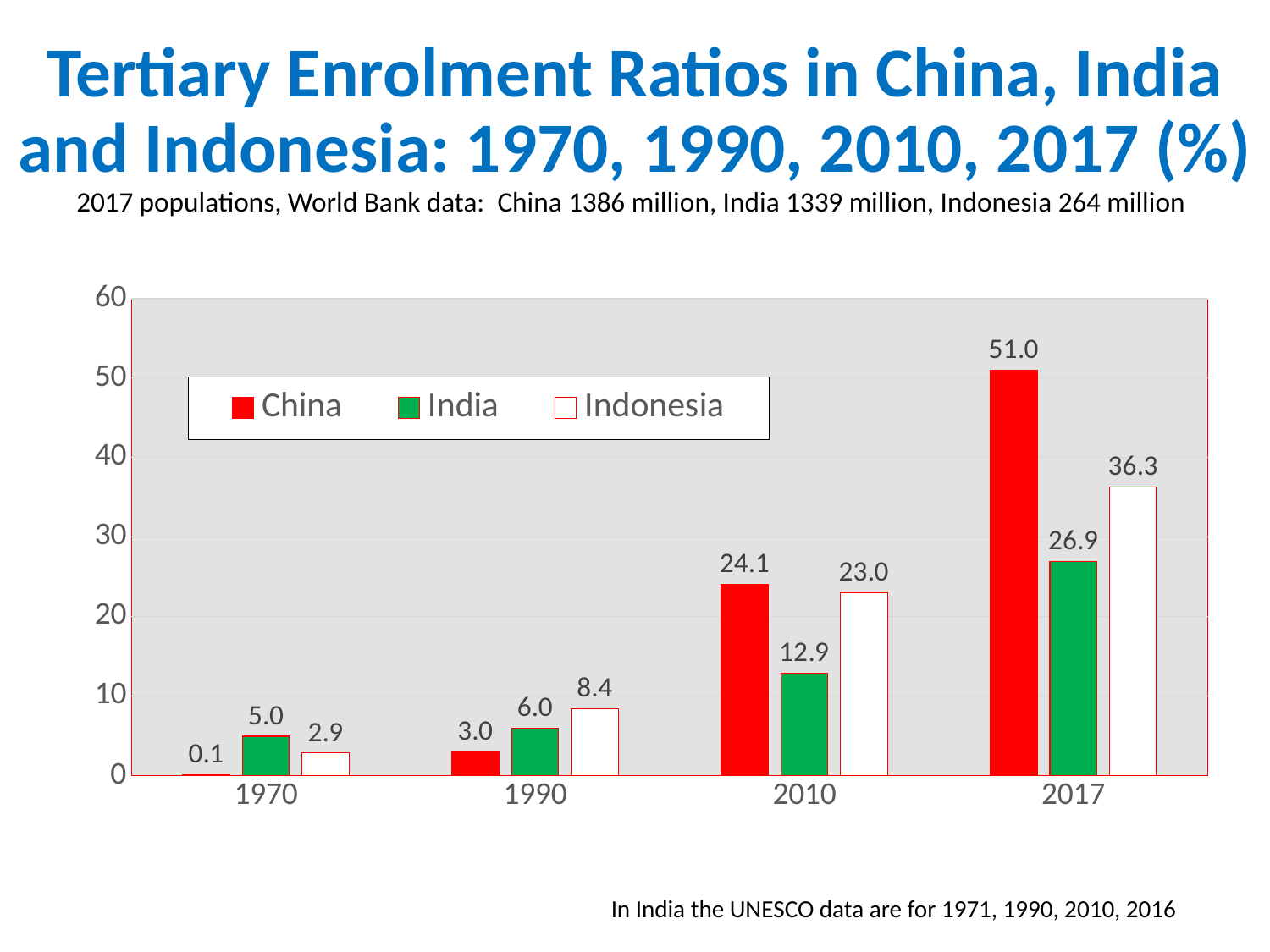
Does the value for China rise or fall from 1990 to 2017? rise What is the difference between China's and India's values in 2017? 24.1 What kind of chart is shown on the slide? bar chart How many series does the legend list? 3 How many years are shown on the x axis? 4 Which country has the highest value in 2017? China Is the value for Indonesia in 2017 greater or less than 30? greater What is the tertiary enrolment ratio for China in 2017? 51.0 Which is larger in 2010, the value for China or the value for Indonesia? China What is the value for Indonesia in 1990? 8.4 What is the value for India in 2010? 12.9 Which country has the lowest value in 1970? China